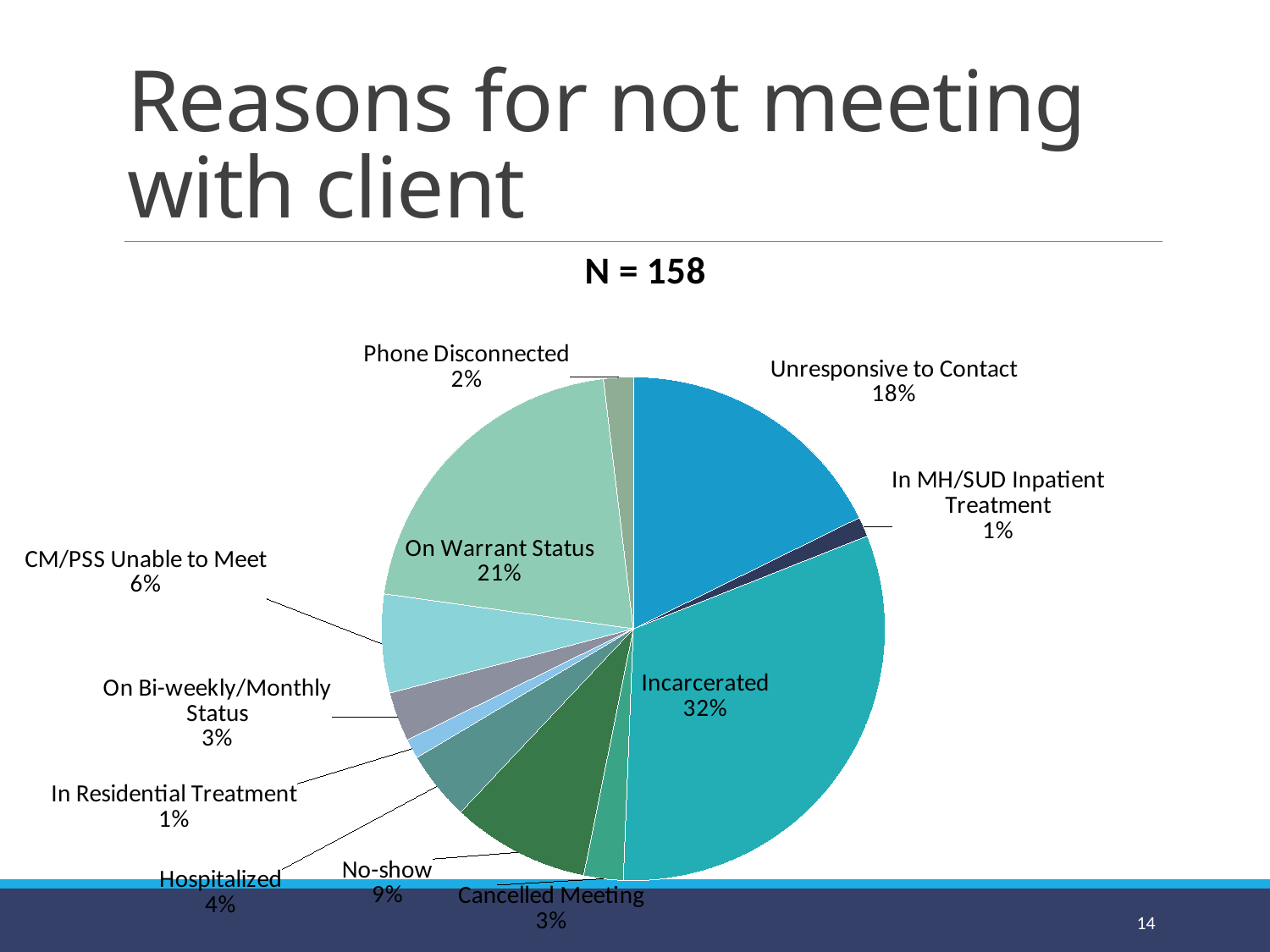
What percentage is shown for No-show? 9% Which is larger, the share for On Warrant Status or the share for Unresponsive to Contact? On Warrant Status What percentage is shown for Unresponsive to Contact? 18% What is the title of the slide containing the chart? Reasons for not meeting with client Which reason has the largest share of the pie? Incarcerated What percentage is shown for CM/PSS Unable to Meet? 6% What is the N value stated above the chart? N = 158 What share of the pie is Incarcerated? 32% How many reasons (slices) are shown in the pie chart? 11 What is the difference in percentage points between Incarcerated and On Warrant Status? 11 What type of chart is shown on the slide? pie chart What percentage is shown for On Warrant Status? 21%